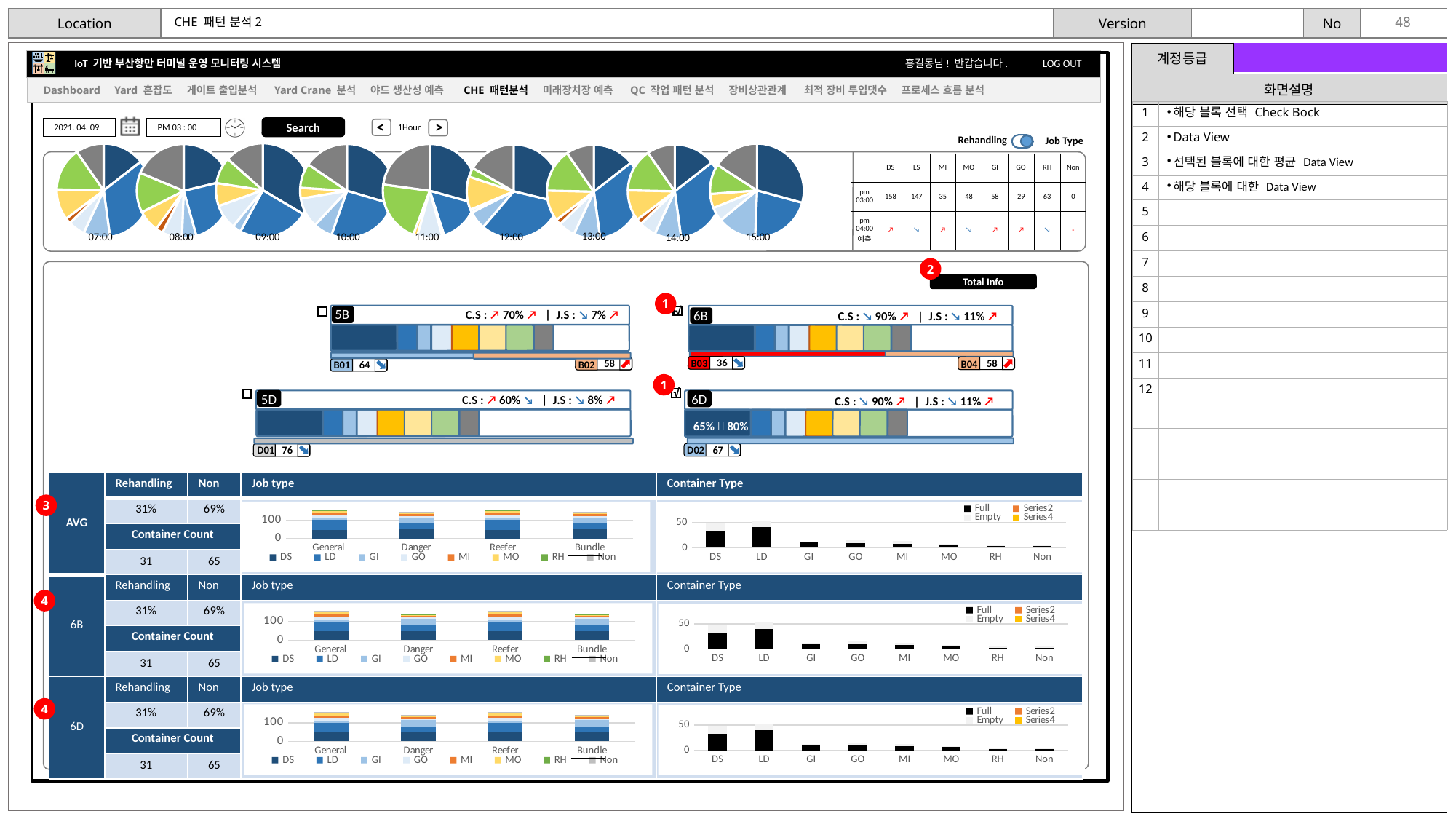
In the 6B row's Container Type chart, which is larger, the bar for DS or the bar for GI? DS What are the x-axis categories of the Job type chart in the 6D row? General, Danger, Reefer, Bundle What kind of chart is the Job type chart in the 6B row? Stacked bar chart What entries appear in the legend of the Container Type chart in the AVG row? Full, Empty, Series2, Series4 How many pie charts are shown in the top row of the dashboard? 9 In the AVG row's Container Type chart, which category has the highest bar? LD In the AVG row's Job type chart, how many categories are on the x axis? 4 In the AVG row's Job type chart, how many series does the legend list? 8 In the AVG row's Container Type chart, how many categories are on the x axis? 8 In the 6D row's Container Type chart, how many entries does the legend list? 4